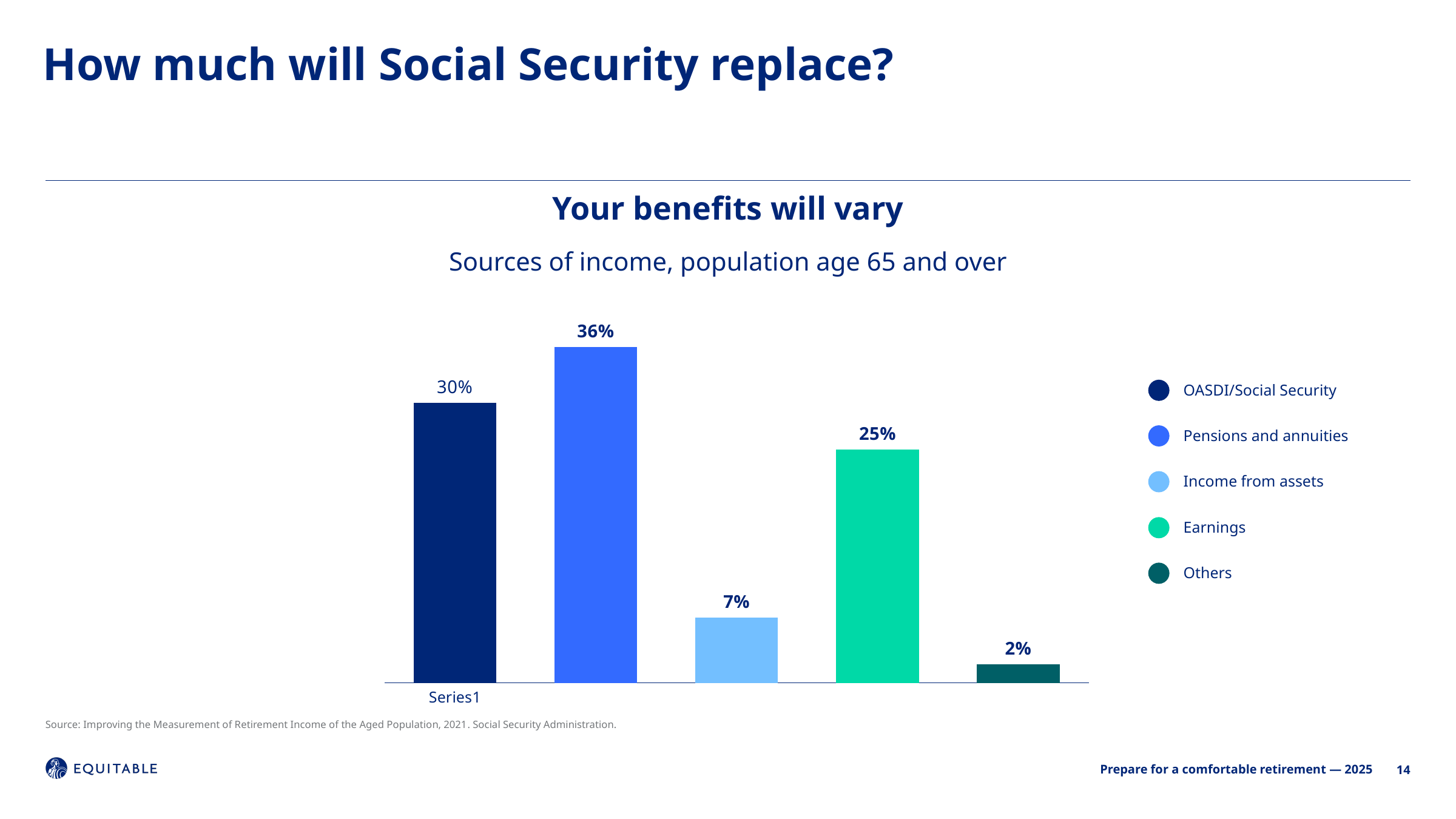
Which is larger, Earnings or Income from assets? Earnings What percentage of income comes from OASDI/Social Security? 30% What is the subtitle of the chart below 'Your benefits will vary'? Sources of income, population age 65 and over What is the value for Pensions and annuities? 36% Which source of income has the highest value? Pensions and annuities How many sources of income are shown in the chart? 5 What is the value for Income from assets? 7% What is the value for Others? 2% What is the difference between Pensions and annuities and OASDI/Social Security? 6% What kind of chart is shown on the slide? Bar chart Which source of income has the lowest value? Others What is the value for Earnings? 25%